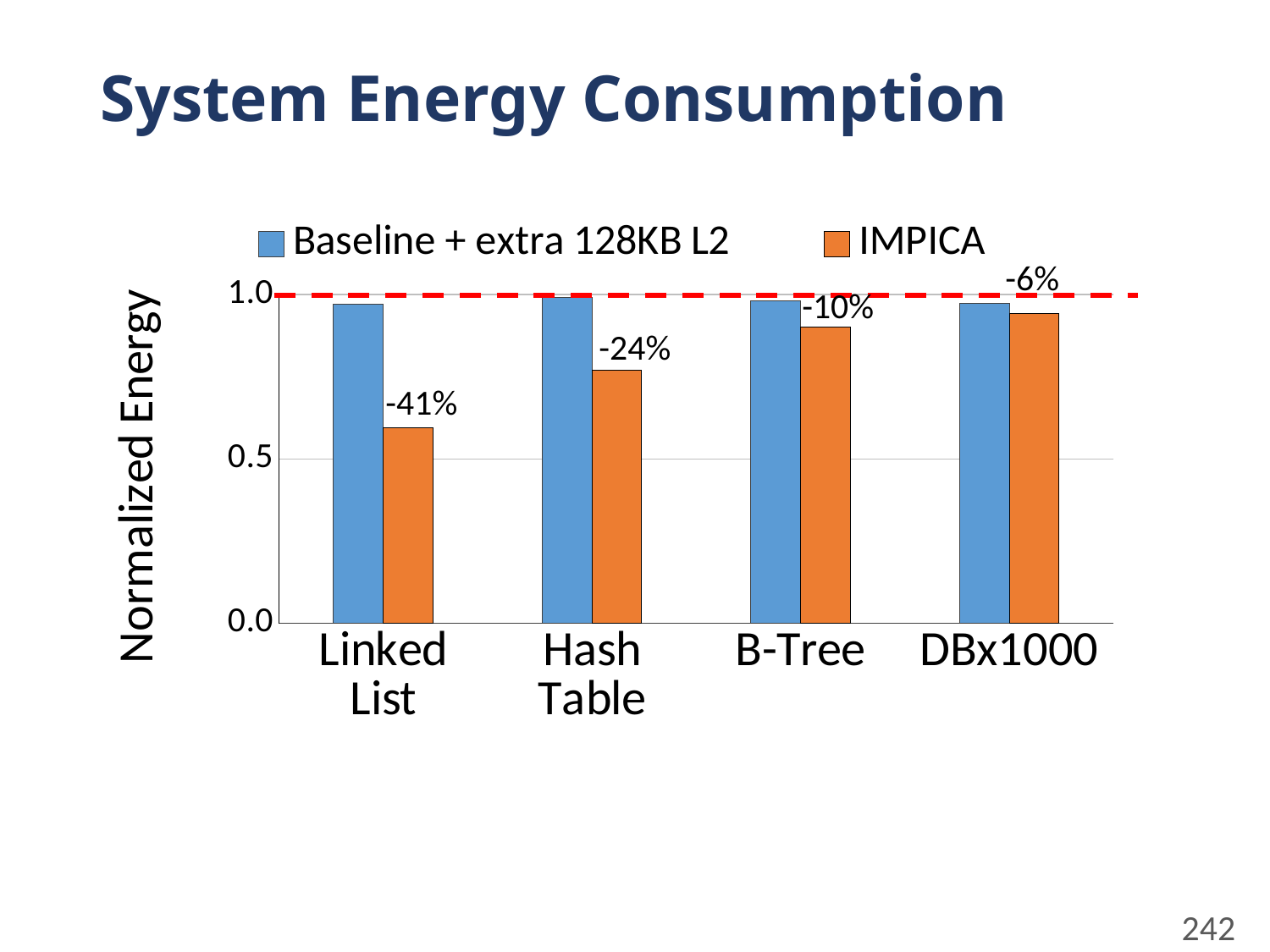
Is the IMPICA value for Linked List greater or less than 0.5? greater Which is larger for Hash Table: the Baseline + extra 128KB L2 bar or the IMPICA bar? Baseline + extra 128KB L2 What kind of chart is shown on the slide? bar chart How many categories are shown on the x axis? 4 What is the label on the y axis? Normalized Energy How many series does the legend list? 2 What percentage reduction is labeled above the IMPICA bar for Linked List? -41% Do the IMPICA values rise or fall from Linked List to DBx1000 along the x axis? rise What percentage reduction is labeled above the IMPICA bar for DBx1000? -6% Which category has the lowest IMPICA normalized energy? Linked List What percentage reduction is labeled above the IMPICA bar for Hash Table? -24% What percentage reduction is labeled above the IMPICA bar for B-Tree? -10%